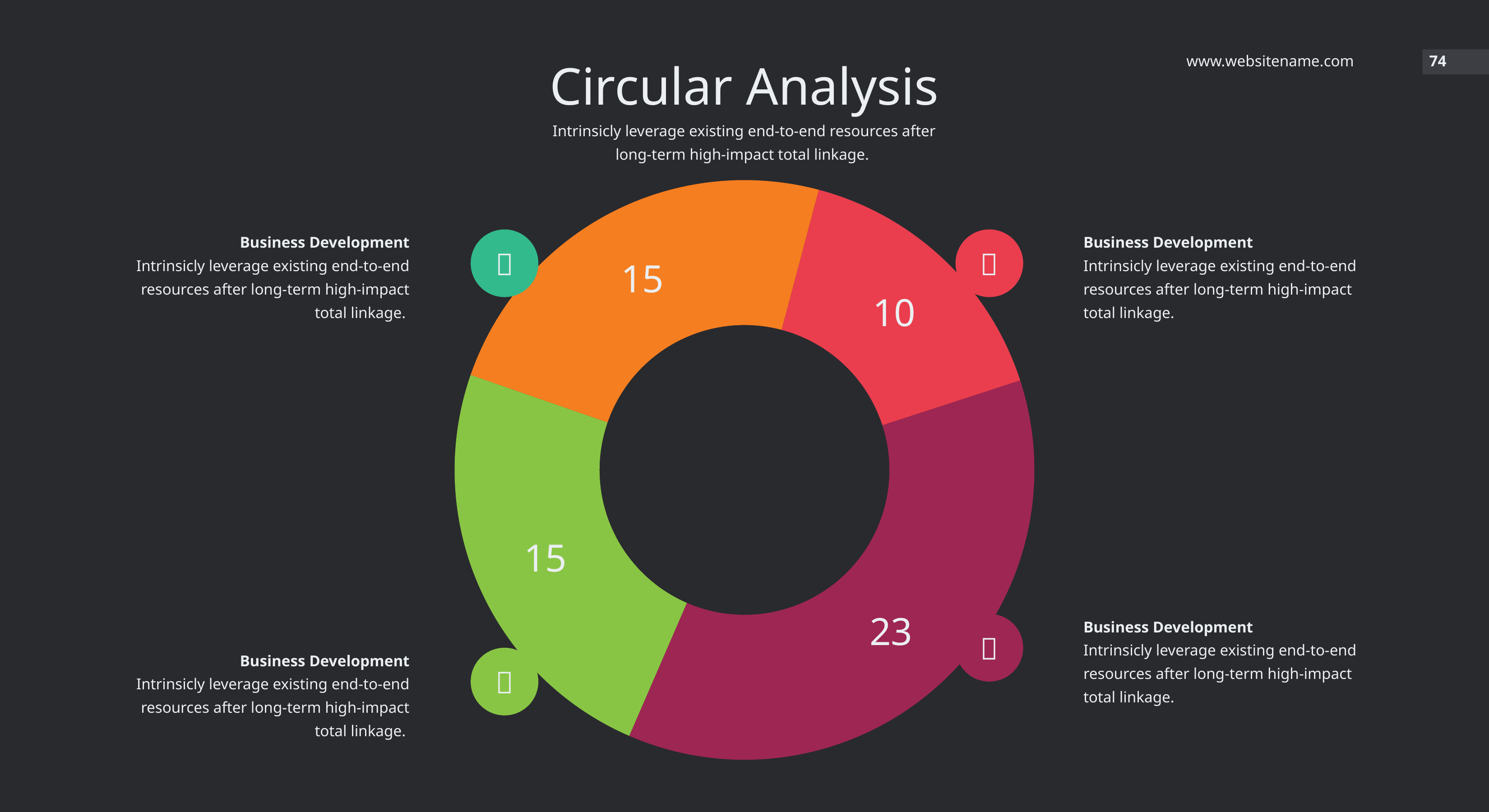
What kind of chart is shown on the slide? Donut chart What is the value of the red slice? 10 What is the title of the slide containing the chart? Circular Analysis What is the value of the orange slice? 15 What is the difference between the magenta slice and the red slice? 13 Which is larger, the green slice or the red slice? The green slice What is the value of the green slice? 15 What is the value of the magenta slice at the bottom right? 23 How many slices does the donut chart have? 4 Which slice has the lowest value? The red slice (10) Which slice has the highest value? The magenta slice (23) What is the total of all the slice values in the donut chart? 63